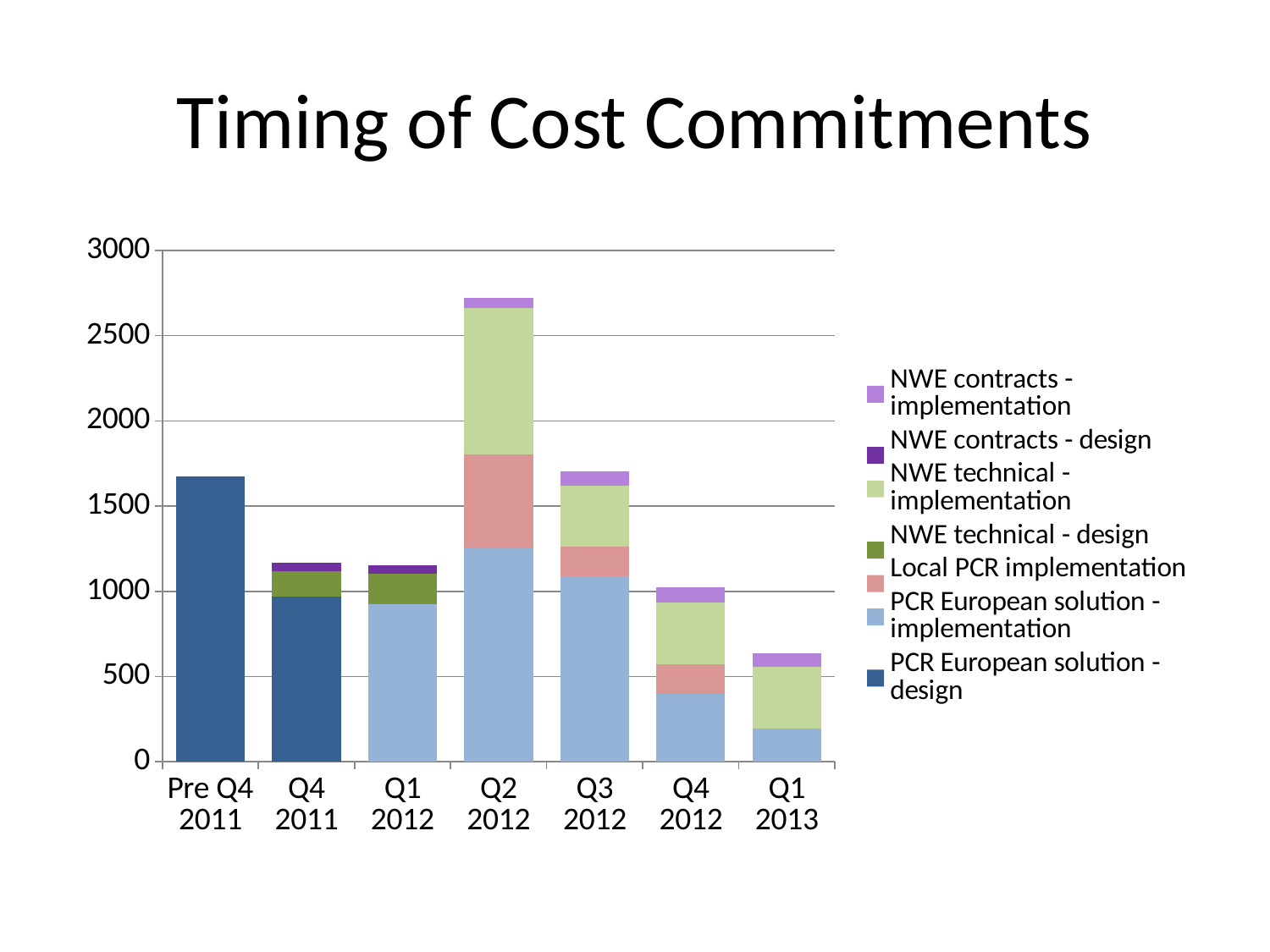
How many time periods (categories) are shown on the x axis? 7 Which bar is taller, Pre Q4 2011 or Q4 2011? Pre Q4 2011 Is the total for Q2 2012 greater or less than 2500? greater Do the stacked bar totals rise or fall from Q2 2012 to Q1 2013? fall What type of chart is shown on the slide? Stacked bar chart What is the title of the chart? Timing of Cost Commitments Which period has the tallest stacked bar? Q2 2012 Is the total for Q1 2013 greater or less than 1000? less Which series is shown only in the Pre Q4 2011 and Q4 2011 bars? PCR European solution - design How many series does the legend list? 7 Which period has the shortest stacked bar? Q1 2013 Is the total for Pre Q4 2011 greater or less than 1500? greater